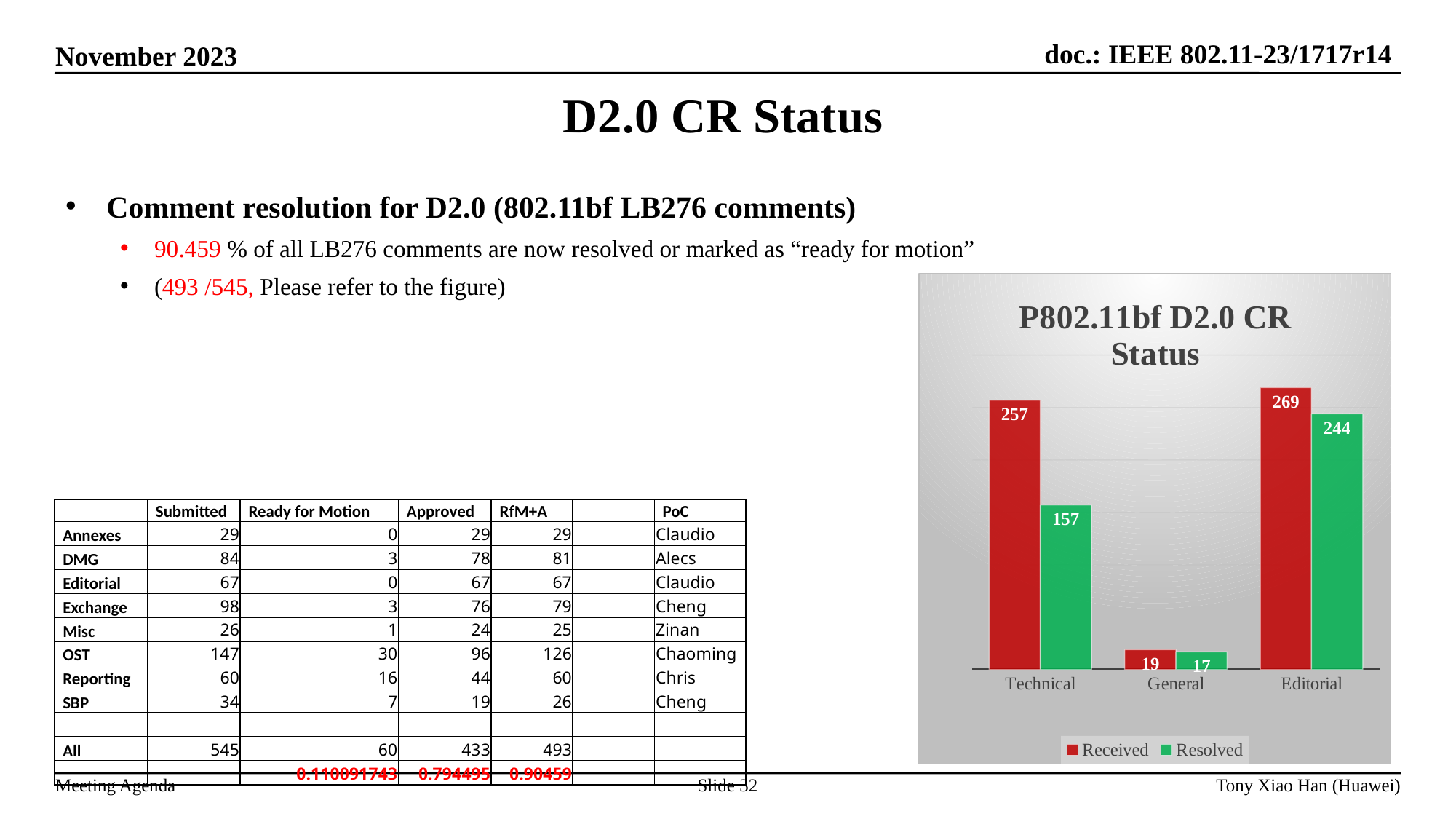
What is the difference between Received and Resolved for Editorial in the chart? 25 What is the title of the chart on the slide? P802.11bf D2.0 CR Status How many categories are shown on the x axis of the chart? 3 How many series does the chart legend list? 2 What is the difference between Received and Resolved for Technical in the chart? 100 What kind of chart is shown on the slide? bar chart Which category has the lowest Resolved value in the chart? General What is the Received value for General in the chart? 19 What is the Received value for Technical in the P802.11bf D2.0 CR Status chart? 257 What is the Resolved value for Editorial in the chart? 244 Which category has the highest Received value in the chart? Editorial Is the Resolved value for Technical larger or smaller than the Resolved value for Editorial? smaller